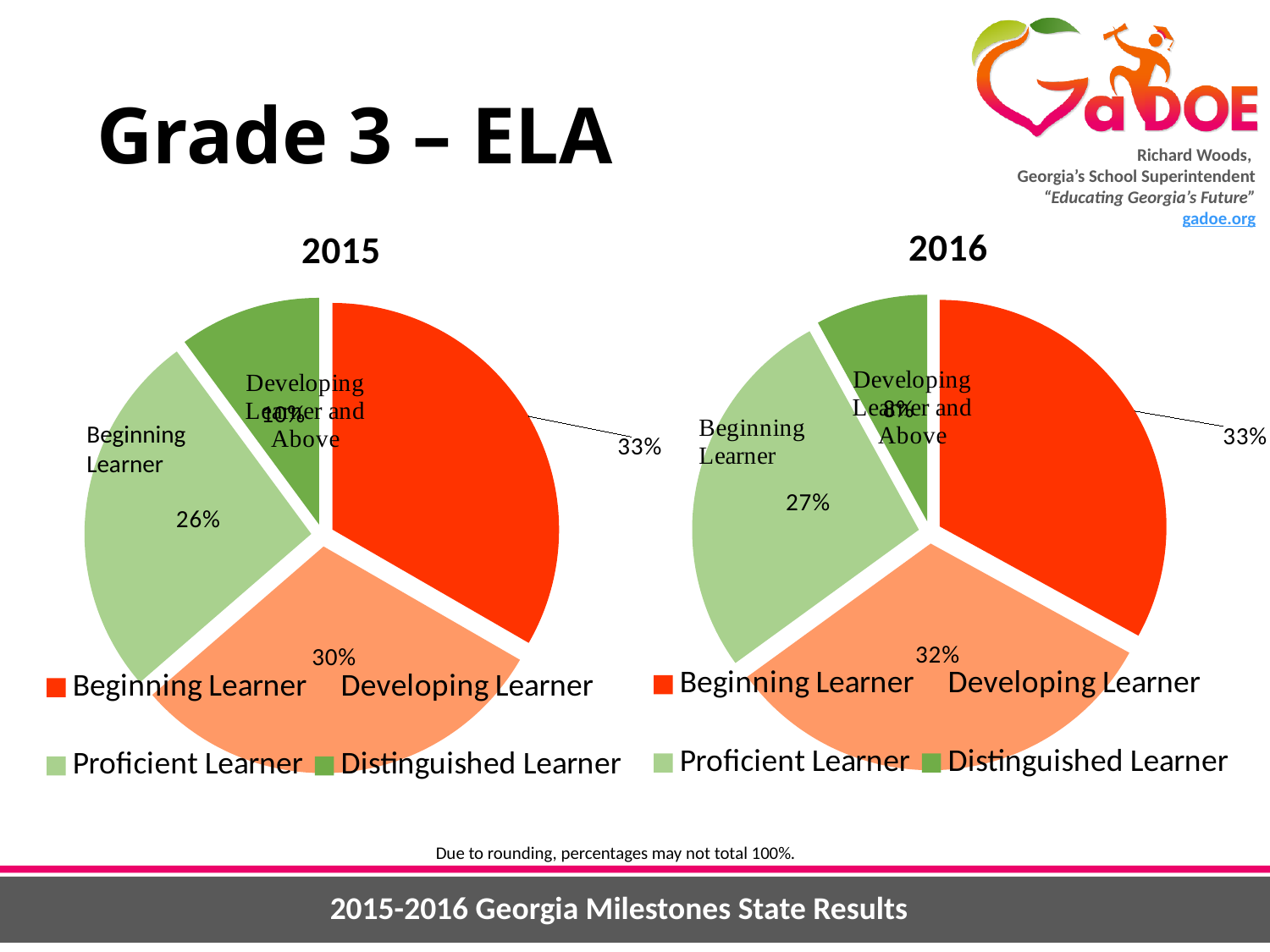
In the 2015 pie chart, what percentage is shown for Proficient Learner? 26% What type of chart is used for the 2015 and 2016 results on this slide? Pie chart In the 2016 pie chart, which category has the smallest slice? Distinguished Learner How many categories does the legend of the 2016 pie chart list? 4 In the 2016 pie chart, what percentage is shown for Beginning Learner? 33% In the 2015 pie chart, what percentage is shown for Beginning Learner? 33% In the 2015 pie chart, which category has the largest slice? Beginning Learner In the 2015 pie chart, how many percentage points larger is Beginning Learner than Proficient Learner? 7 percentage points In the 2016 pie chart, which is larger: Developing Learner or Proficient Learner? Developing Learner In the 2016 pie chart, what percentage is shown for Developing Learner? 32% In the 2016 pie chart, what percentage is shown for Proficient Learner? 27% In the 2015 pie chart, what percentage is shown for Developing Learner? 30%